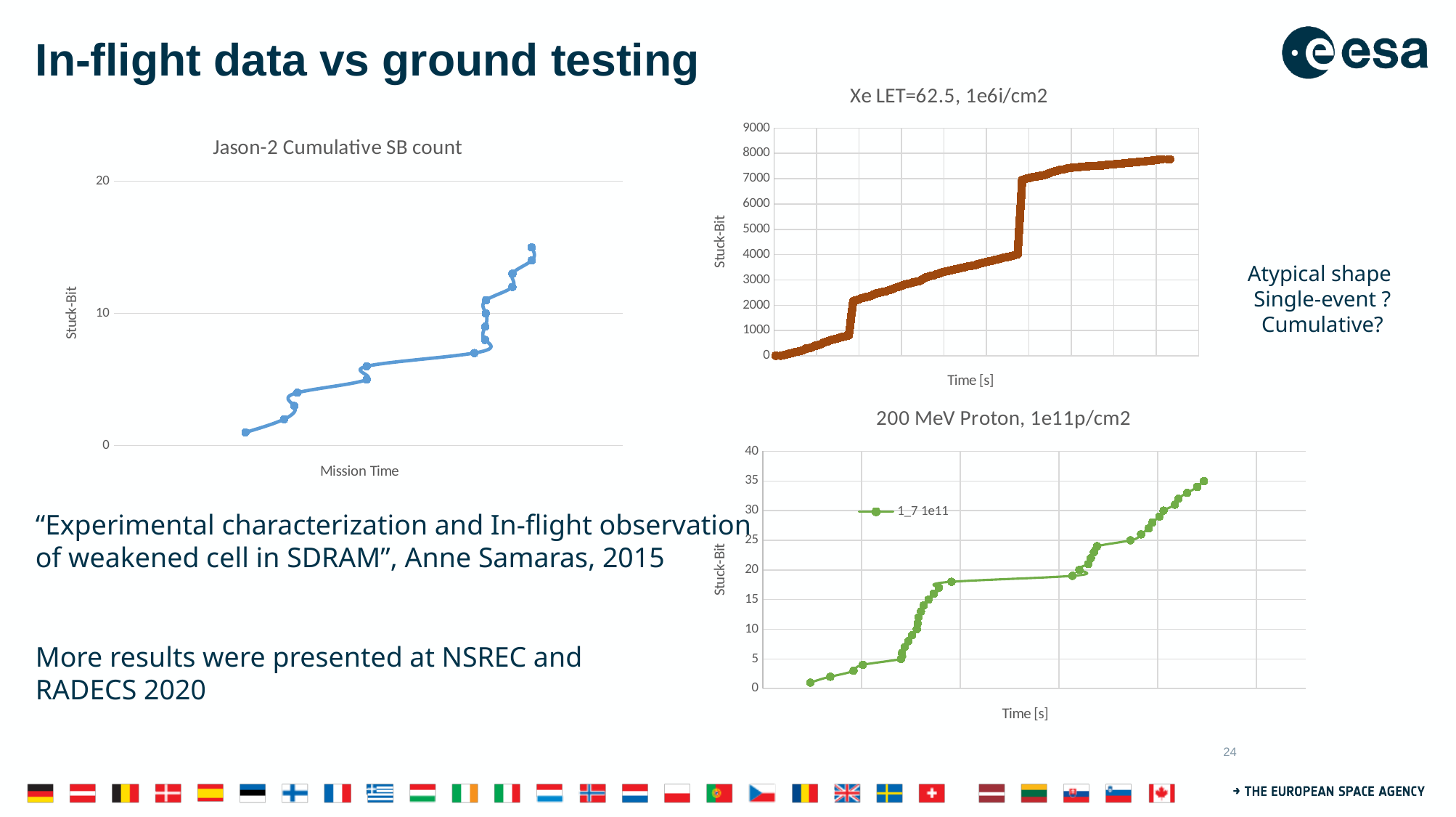
In the "Xe LET=62.5, 1e6i/cm2" chart, do the values rise or fall over time? rise In the "200 MeV Proton, 1e11p/cm2" chart, is the highest plotted value greater or less than 30? greater In the "Jason-2 Cumulative SB count" chart, is the highest plotted value greater or less than 10? greater How many series does the legend of the "200 MeV Proton, 1e11p/cm2" chart list? 1 What is the x-axis label of the "Xe LET=62.5, 1e6i/cm2" chart? Time [s] In the "Xe LET=62.5, 1e6i/cm2" chart, is the final plotted value greater or less than 8000? less What kind of chart is the "Jason-2 Cumulative SB count" chart? line chart What kind of chart is the "200 MeV Proton, 1e11p/cm2" chart? line chart In the "Jason-2 Cumulative SB count" chart, do the values rise or fall along the x axis? rise What is the y-axis label of the "Jason-2 Cumulative SB count" chart? Stuck-Bit